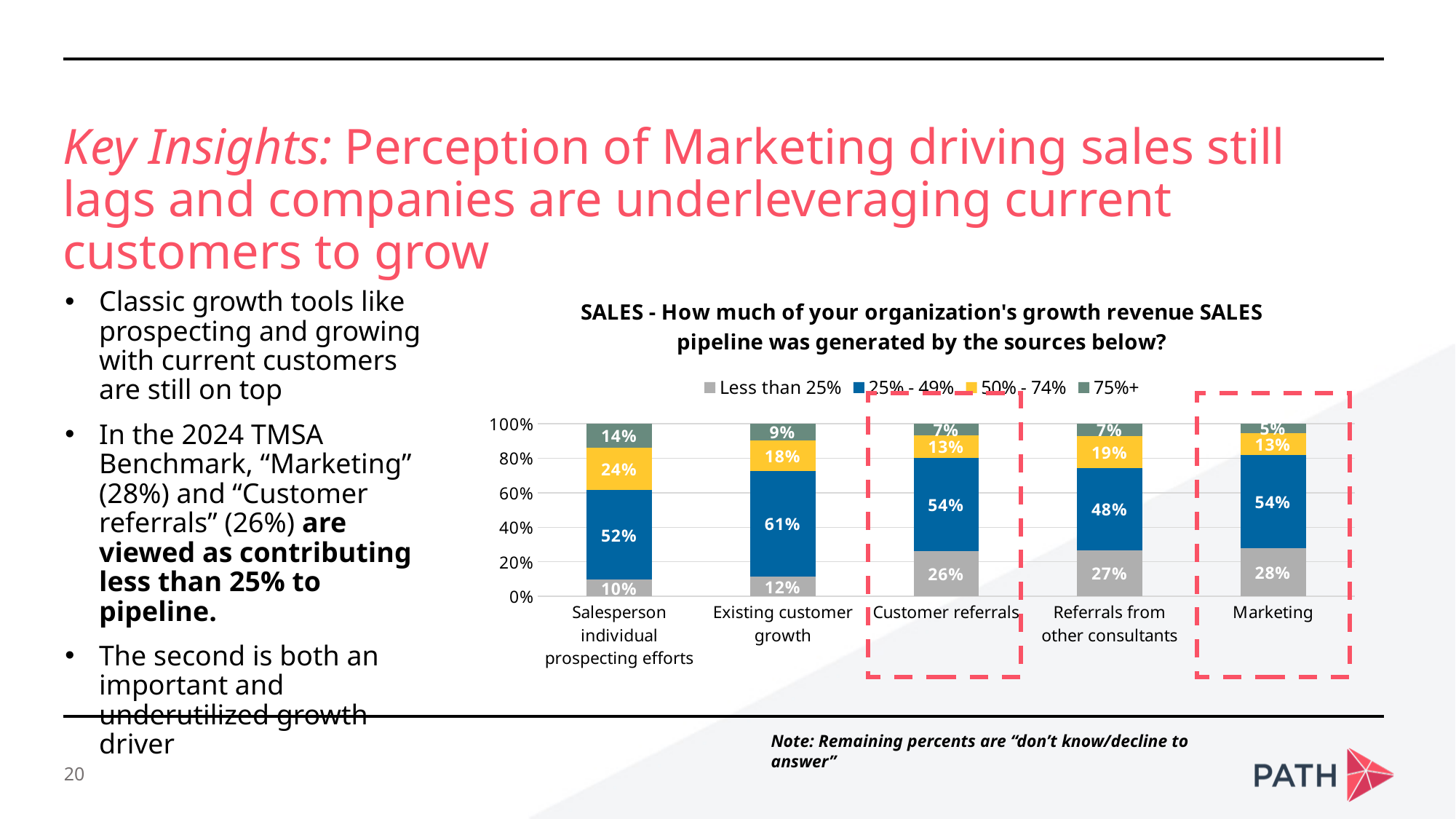
What is the '25% - 49%' value for Existing customer growth? 61% Which legend entry is shown in yellow? 50% - 74% What is the 'Less than 25%' value for Marketing? 28% Which category has the lowest '75%+' value? Marketing How many source categories are shown on the x axis? 5 What is the '50% - 74%' value for Referrals from other consultants? 19% What kind of chart is shown on the slide? Stacked bar chart What is the '75%+' value for Salesperson individual prospecting efforts? 14% Which is larger: the '50% - 74%' value for Salesperson individual prospecting efforts or for Customer referrals? Salesperson individual prospecting efforts How many series does the legend list? 4 Which category has the highest 'Less than 25%' value? Marketing What is the difference between the '25% - 49%' values for Existing customer growth and Referrals from other consultants? 13%